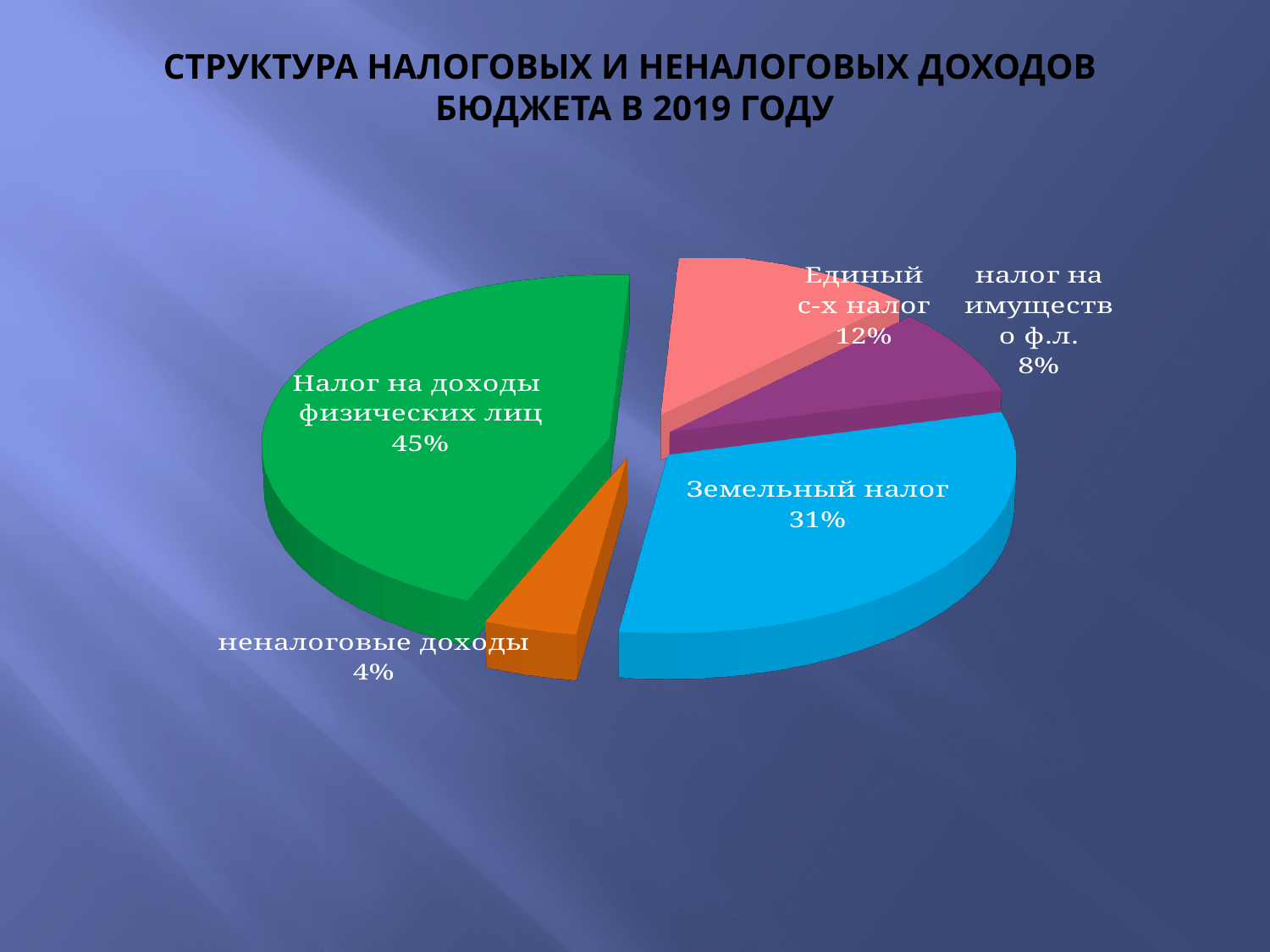
What share of the pie is налог на имущество ф.л.? 8% Which is larger, Единый с-х налог or налог на имущество ф.л.? Единый с-х налог How many slices does the pie chart have? 5 What share of the pie is Налог на доходы физических лиц? 45% What share of the pie is Единый с-х налог? 12% What is the difference in percentage points between Налог на доходы физических лиц and Земельный налог? 14 What is the title of the slide containing the chart? СТРУКТУРА НАЛОГОВЫХ И НЕНАЛОГОВЫХ ДОХОДОВ БЮДЖЕТА В 2019 ГОДУ What kind of chart is shown on the slide? pie chart Which slice of the pie is the largest? Налог на доходы физических лиц Which slice of the pie is the smallest? неналоговые доходы